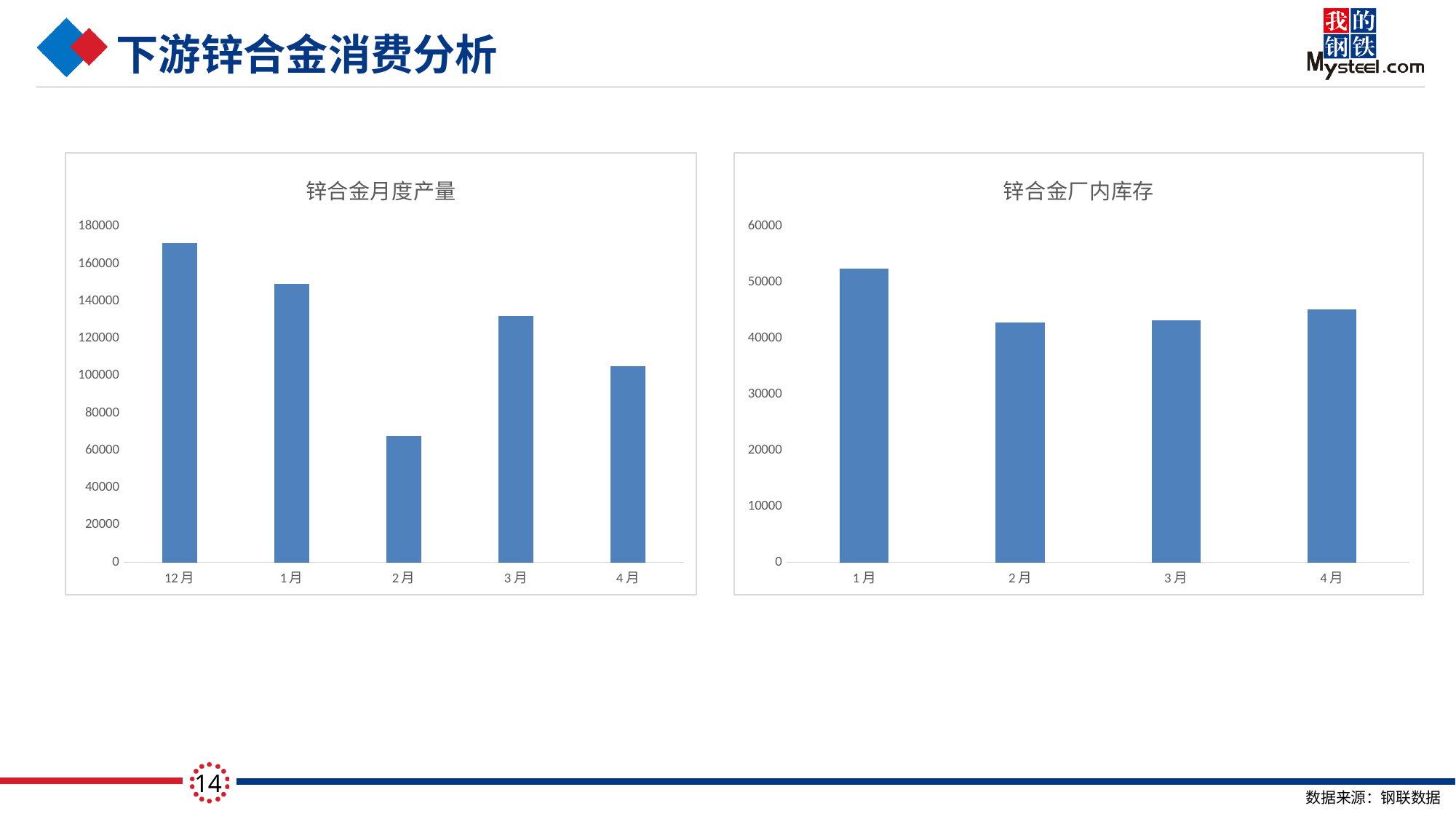
In the 锌合金月度产量 chart, which month has the highest value? 12月 In the 锌合金月度产量 chart, is the value for 4月 greater or less than 100000? greater What type of chart is the 锌合金厂内库存 chart? bar chart How many months are shown in the 锌合金月度产量 chart? 5 In the 锌合金月度产量 chart, is the value for 2月 greater or less than 80000? less In the 锌合金厂内库存 chart, is the value for 2月 greater or less than 40000? greater How many months are shown in the 锌合金厂内库存 chart? 4 In the 锌合金厂内库存 chart, which month has the highest value? 1月 In the 锌合金月度产量 chart, which month has the lowest value? 2月 In the 锌合金月度产量 chart, which is larger, the value for 1月 or the value for 3月? 1月